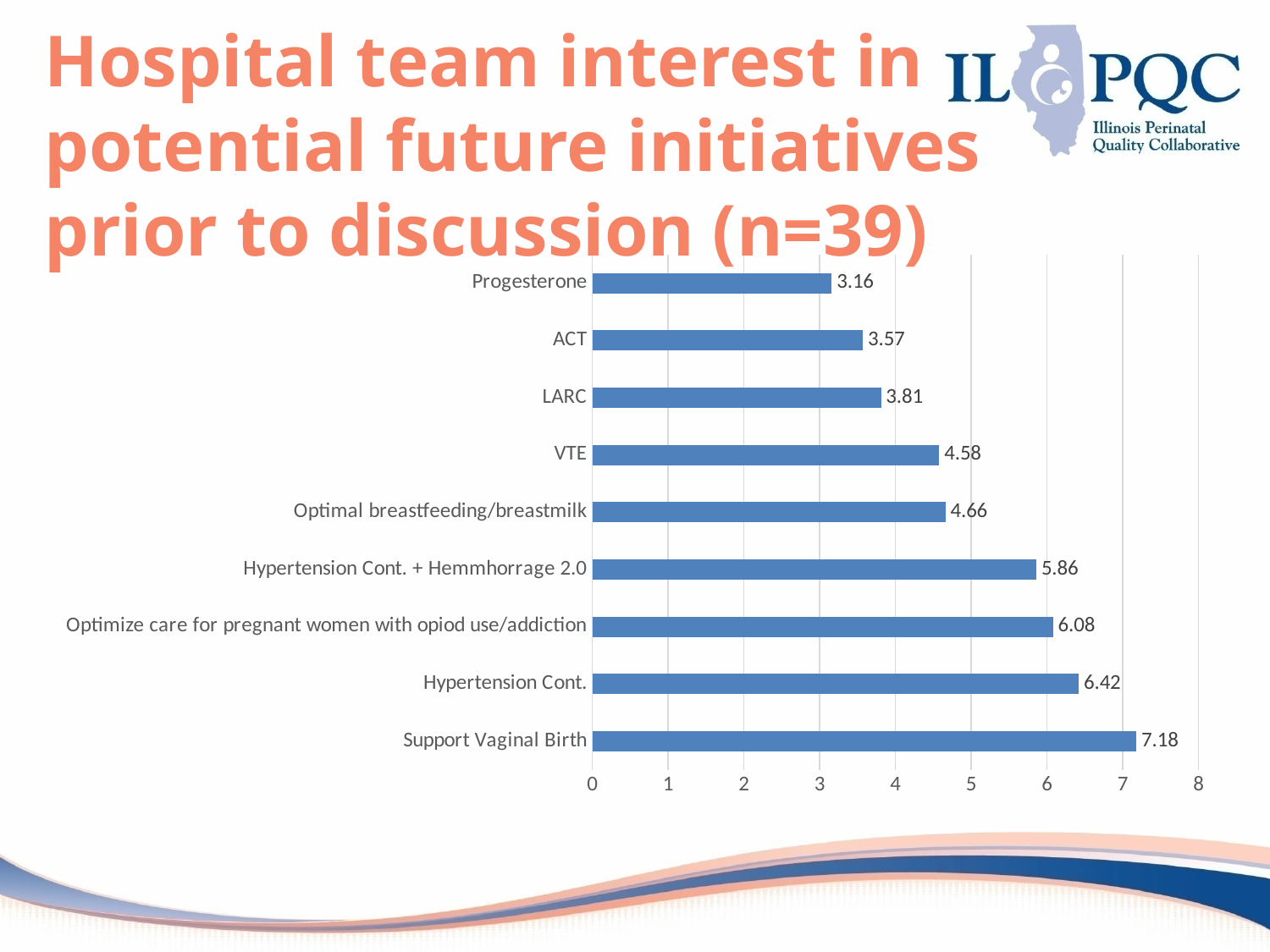
What is the value for Support Vaginal Birth? 7.18 How many categories are shown in the chart? 9 Is the value for Hypertension Cont. + Hemmhorrage 2.0 greater or less than 5? greater What is the maximum value shown on the horizontal axis? 8 What is the difference between the values for Optimal breastfeeding/breastmilk and VTE? 0.08 Which is larger, the value for LARC or the value for ACT? LARC Which category has the highest value? Support Vaginal Birth What is the value for VTE? 4.58 Which category has the lowest value? Progesterone What kind of chart is shown on the slide? Bar chart What is the difference between the values for Hypertension Cont. and Progesterone? 3.26 What is the value for Optimize care for pregnant women with opiod use/addiction? 6.08